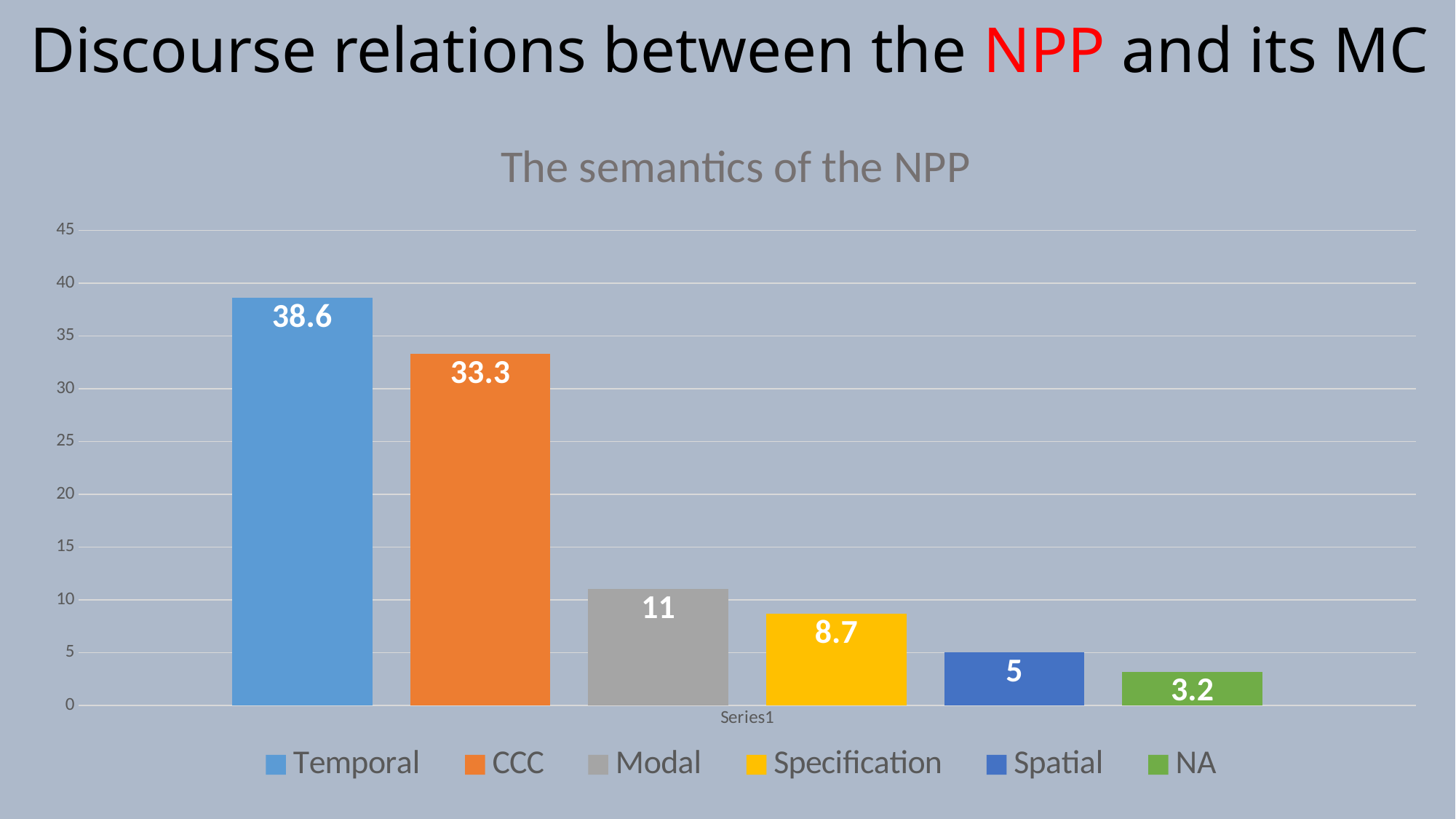
What is the difference between the values for Temporal and CCC? 5.3 What is the value for Temporal? 38.6 What kind of chart is shown on the slide? Bar chart What is the difference between the values for Modal and Spatial? 6 What is the title of the chart? The semantics of the NPP How many categories are shown in the chart? 6 Which category has the lowest value? NA What is the value for CCC? 33.3 What is the value for NA? 3.2 What is the value for Specification? 8.7 Which is larger, the value for Modal or the value for Specification? Modal Which category has the highest value? Temporal